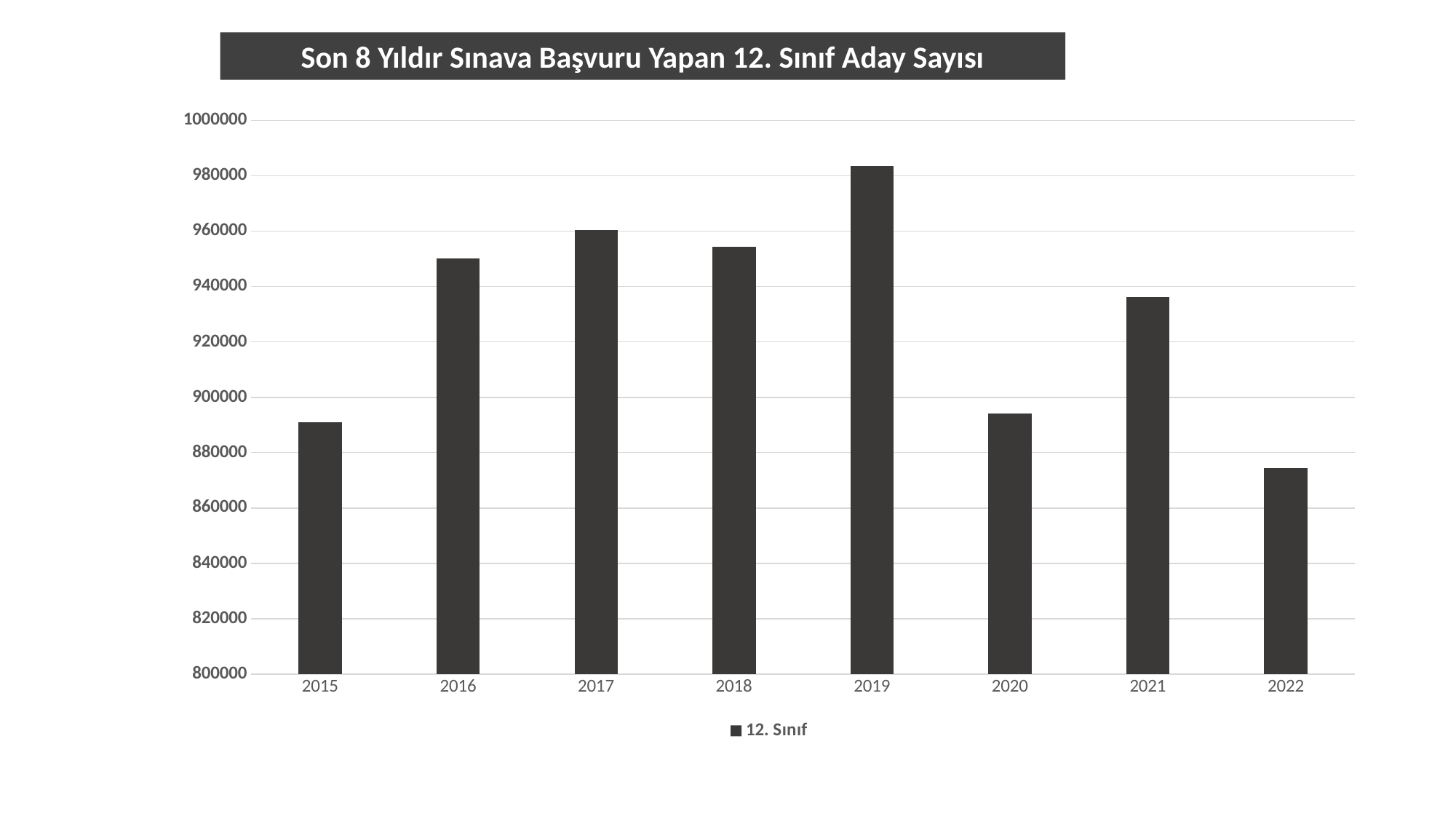
How many series does the legend list? 1 Which year has the highest number of 12. Sınıf applicants? 2019 How many years are shown on the x axis? 8 Is the value for 2015 greater or less than 900000? less What is the title of the chart? Son 8 Yıldır Sınava Başvuru Yapan 12. Sınıf Aday Sayısı Which year has the larger value, 2017 or 2016? 2017 Is the value for 2016 greater or less than 940000? greater Is the value for 2022 greater or less than 880000? less What kind of chart is shown on the slide? bar chart Which year has the lowest number of 12. Sınıf applicants? 2022